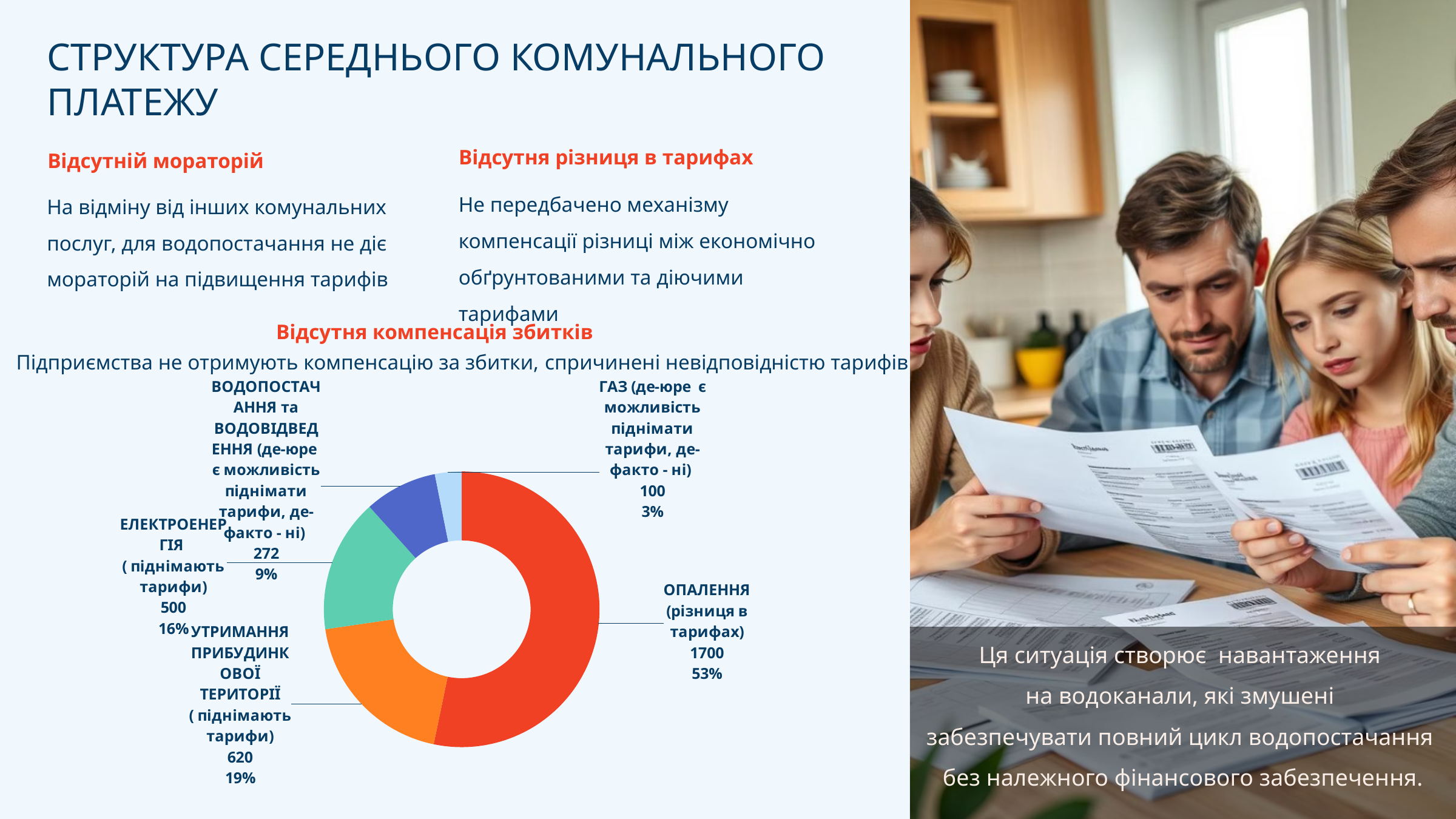
What colour is the ОПАЛЕННЯ segment in the donut chart? Red How many categories are shown in the donut chart? 5 What share of the donut chart does УТРИМАННЯ ПРИБУДИНКОВОЇ ТЕРИТОРІЇ represent? 19% What share of the donut chart does ЕЛЕКТРОЕНЕРГІЯ represent? 16% Which is larger: the value for ЕЛЕКТРОЕНЕРГІЯ or the value for ВОДОПОСТАЧАННЯ та ВОДОВІДВЕДЕННЯ? ЕЛЕКТРОЕНЕРГІЯ Which category has the smallest value in the donut chart? ГАЗ What value is shown for ОПАЛЕННЯ in the donut chart? 1700 What kind of chart is shown on the slide? Donut (pie) chart What is the difference between the values for ОПАЛЕННЯ and УТРИМАННЯ ПРИБУДИНКОВОЇ ТЕРИТОРІЇ? 1080 What value is shown for ВОДОПОСТАЧАННЯ та ВОДОВІДВЕДЕННЯ in the donut chart? 272 What share of the donut chart does ГАЗ represent? 3% Which category has the largest value in the donut chart? ОПАЛЕННЯ